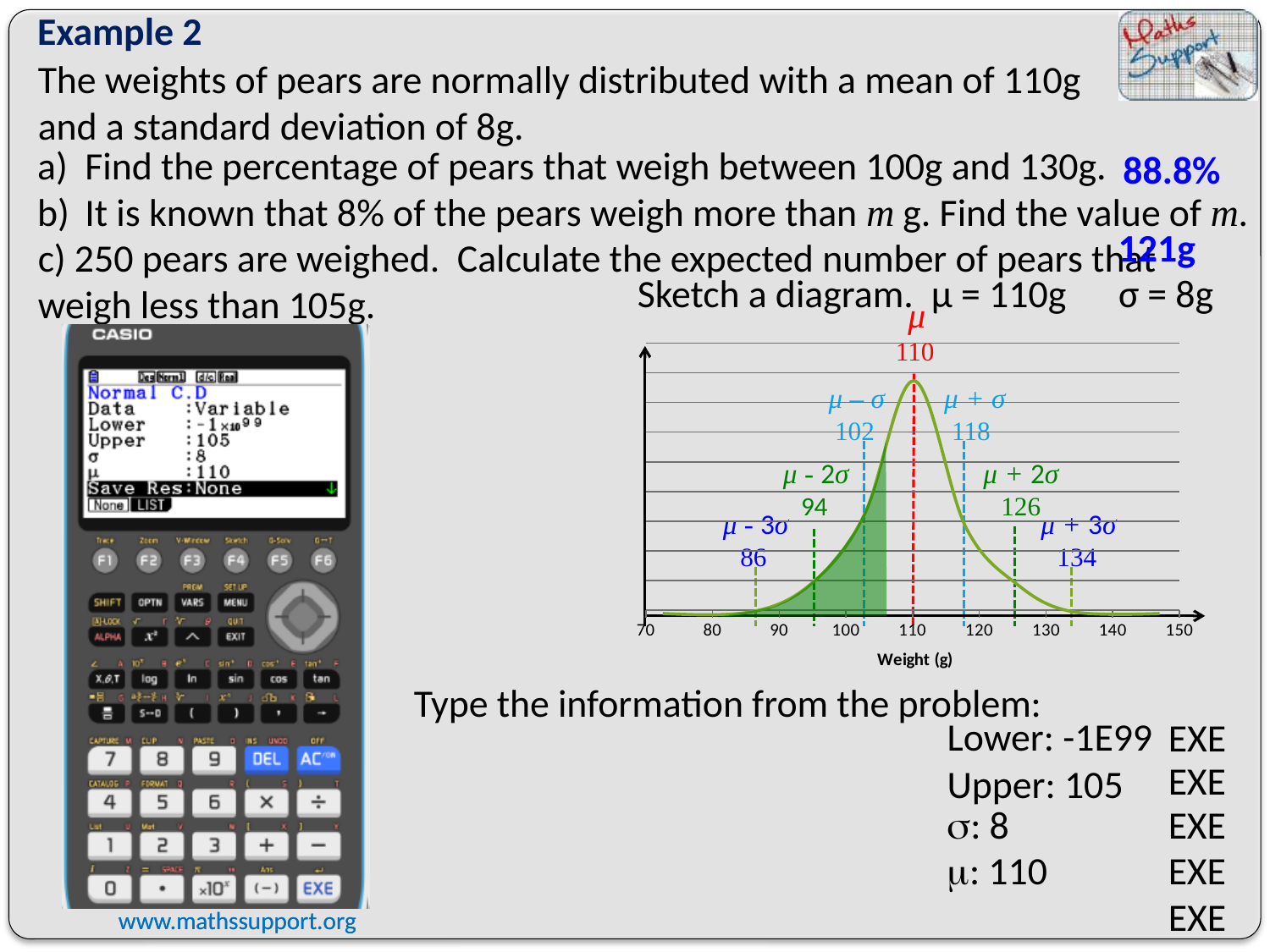
What is the title of the x axis on the sketch? Weight (g) What value is labelled at μ − 3σ on the sketch? 86 What value is labelled at μ + σ on the sketch? 118 Which labelled value on the sketch is larger, μ + 2σ or μ − 2σ? μ + 2σ Does the curve rise or fall along the x axis from 70 to 110? rise What kind of chart is the sketch of the distribution? line chart What is the difference between the values labelled at μ + σ and μ − σ on the sketch? 16 What value is labelled at μ on the normal distribution sketch? 110 Does the curve rise or fall along the x axis from 110 to 150? fall What value is labelled at μ + 2σ on the sketch? 126 What value is labelled at μ + 3σ on the sketch? 134 What value is labelled at μ − σ on the sketch? 102